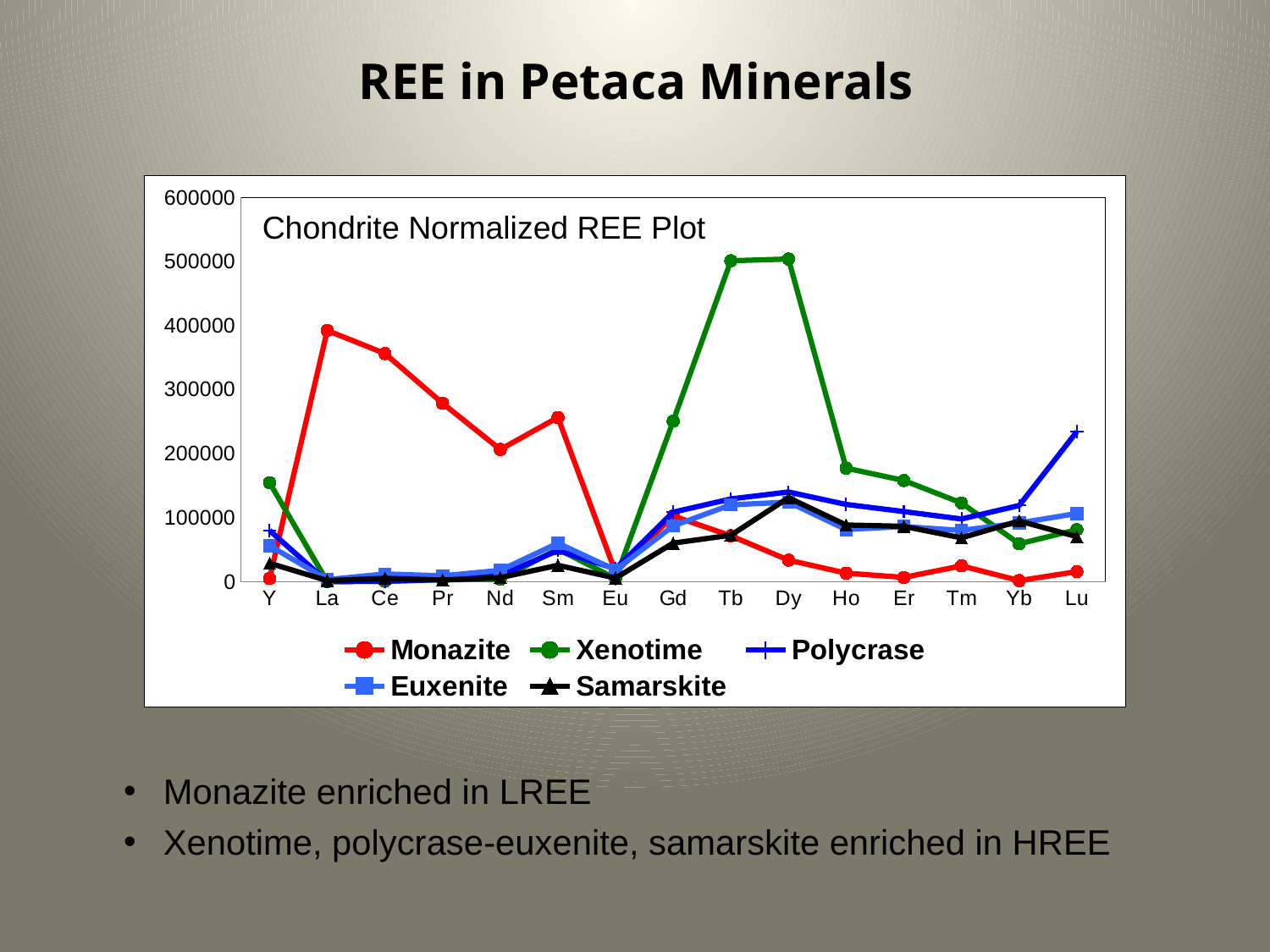
Is the value for Monazite at Lu greater or less than 100000? less Is the value for Monazite at La greater or less than 300000? greater What kind of chart is shown on the slide? line chart How many categories are shown along the x axis? 15 What title is printed inside the plot area? Chondrite Normalized REE Plot At which category does Monazite reach its highest value? La Is the value for Polycrase at Lu greater or less than 200000? greater Which series has the highest value at Tb? Xenotime Do the Xenotime values rise or fall from Dy to Yb? fall How many series does the legend list? 5 Which is larger at Dy, the Xenotime value or the Monazite value? Xenotime